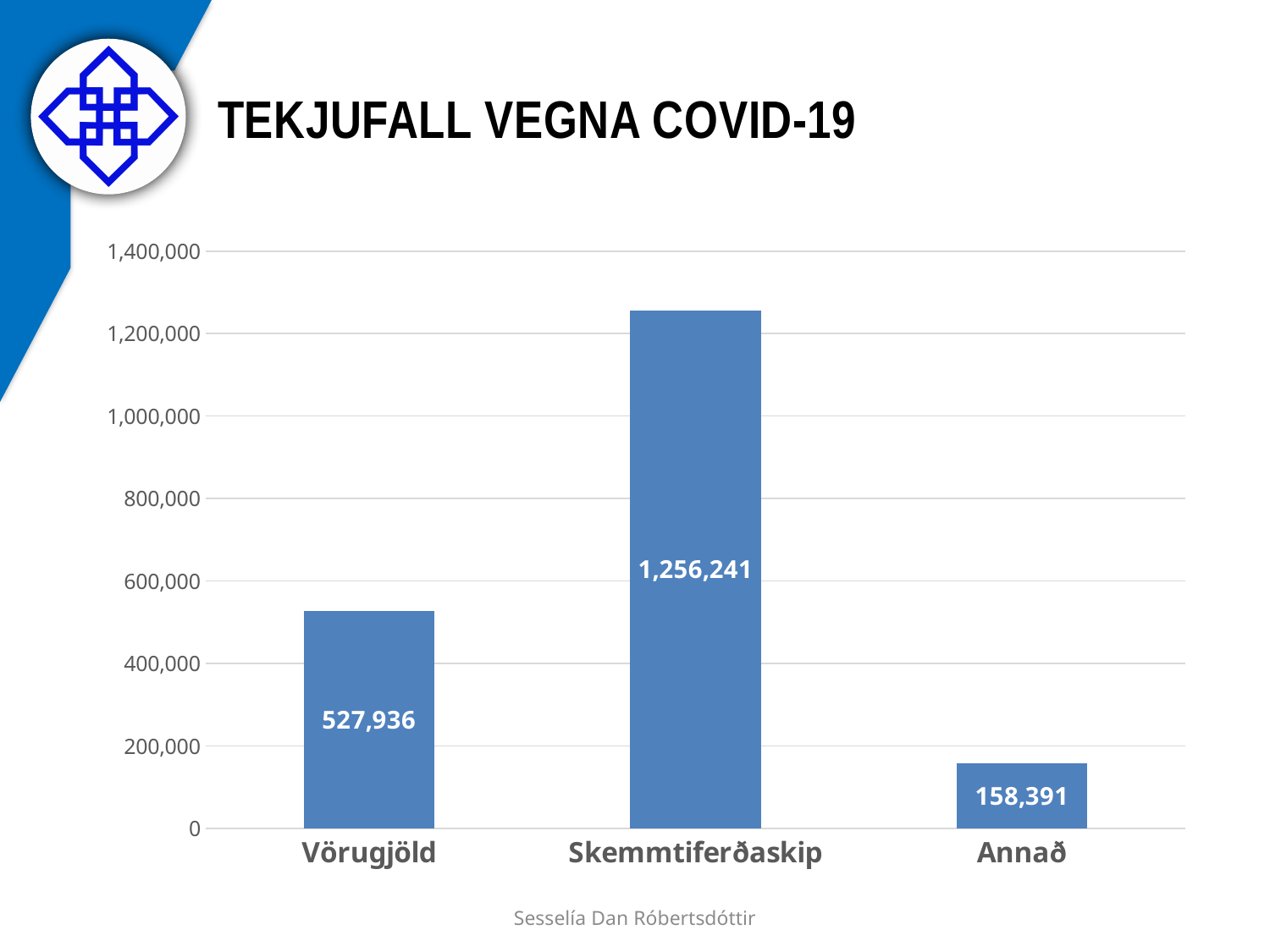
What is the difference between the values for Vörugjöld and Annað? 369,545 What is the value for Annað? 158,391 What is the difference between the values for Skemmtiferðaskip and Vörugjöld? 728,305 Which category has the lowest value? Annað What is the value for Vörugjöld? 527,936 What is the title of the slide containing the chart? TEKJUFALL VEGNA COVID-19 Which is larger, the value for Vörugjöld or the value for Annað? Vörugjöld What is the value for Skemmtiferðaskip? 1,256,241 Which category has the highest value? Skemmtiferðaskip What kind of chart is shown on the slide? bar chart How many categories are shown on the x axis? 3 Is the value for Skemmtiferðaskip greater or less than 1,200,000? greater